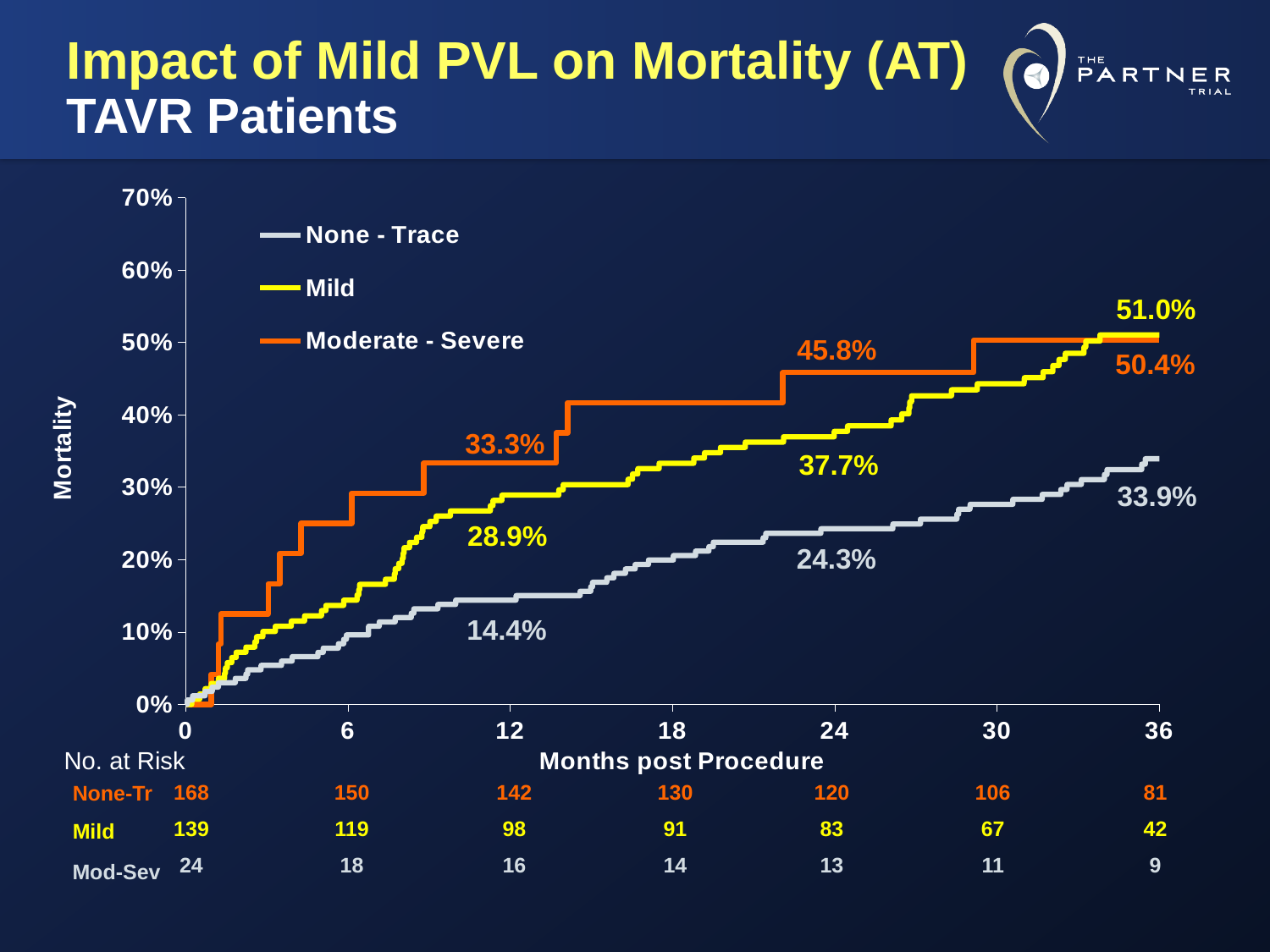
How many patients in the Mild group are at risk at 36 months? 42 What is the mortality for the Moderate - Severe group at 36 months post procedure? 50.4% How many series does the legend list? 3 Is the mortality for the Mild group at 6 months greater or less than 20%? less Do the mortality curves rise or fall as months post procedure increase? Rise What kind of chart is shown on the slide? Line chart Which group has the highest mortality at 12 months post procedure? Moderate - Severe What is the mortality for the None - Trace group at 24 months post procedure? 24.3% What colour is the Mild line in the legend? Yellow At 24 months, which group has higher mortality: Mild or Moderate - Severe? Moderate - Severe What is the difference in mortality between the Mild and None - Trace groups at 36 months? 17.1 percentage points What is the mortality for the Mild group at 12 months post procedure? 28.9%